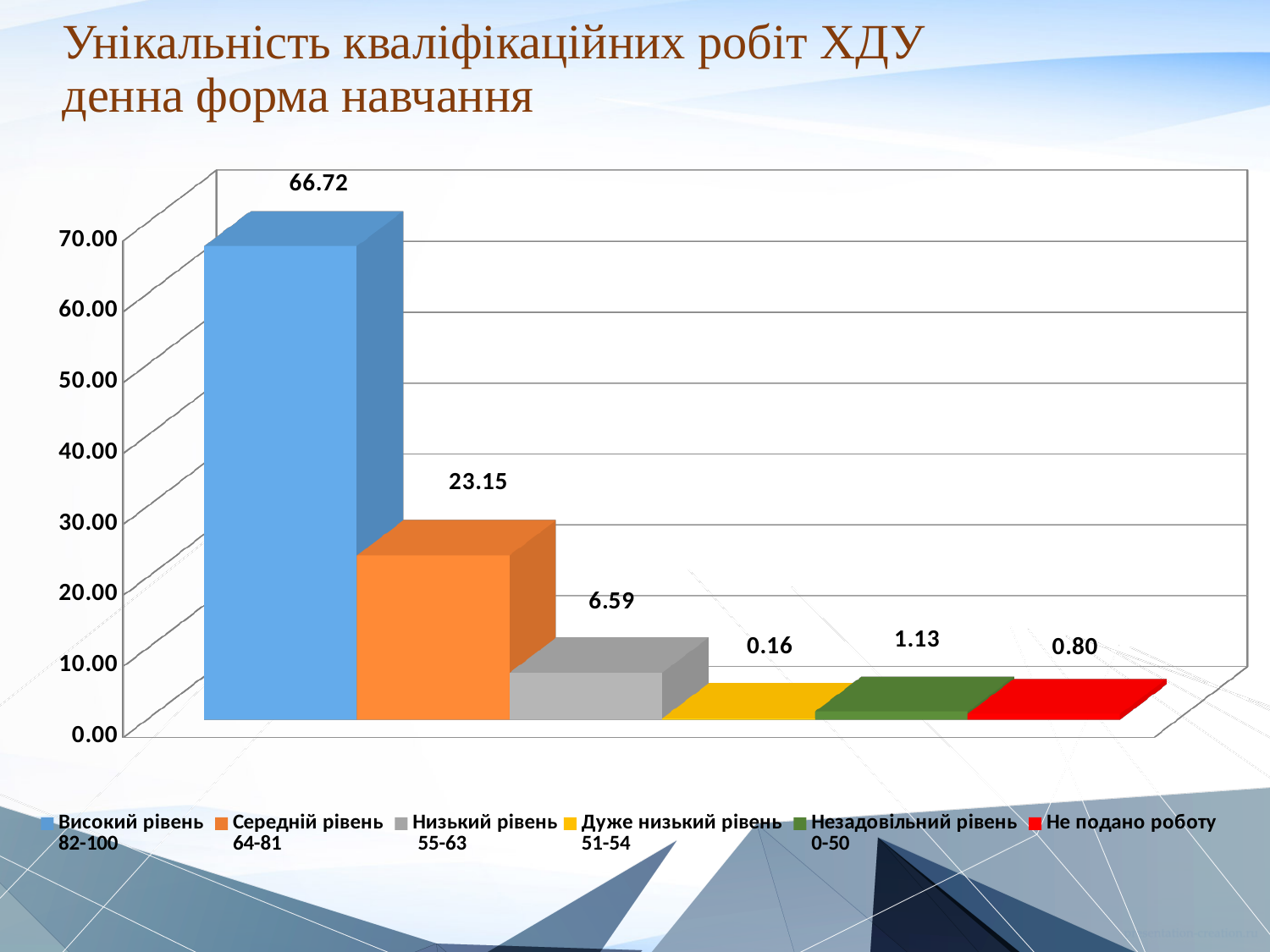
What is the value for Середній рівень 64-81? 23.15 What is the value for Не подано роботу? 0.80 How many entries does the legend list? 6 How many bars are plotted in the chart? 6 What is the difference between the values for Високий рівень 82-100 and Середній рівень 64-81? 43.57 Which category has the highest value? Високий рівень 82-100 Which category has the lowest value? Дуже низький рівень 51-54 What kind of chart is shown on the slide? bar chart Is the value for Середній рівень 64-81 greater or less than 20.00? greater What is the value for Низький рівень 55-63? 6.59 Which is larger, the value for Незадовільний рівень 0-50 or the value for Не подано роботу? Незадовільний рівень 0-50 What is the value for Високий рівень 82-100? 66.72